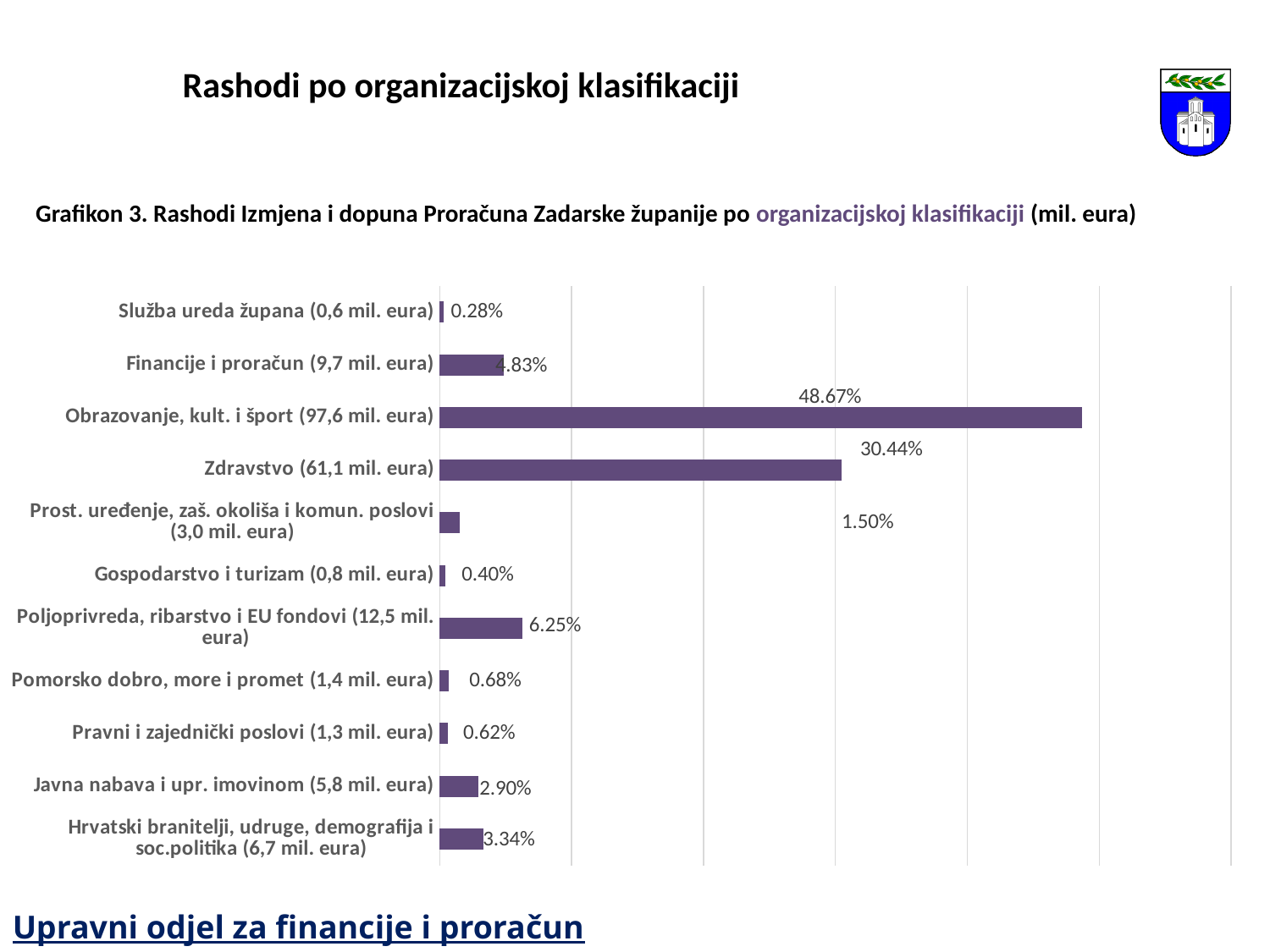
How many categories are shown in the chart? 11 What is the title of the chart (Grafikon 3)? Rashodi Izmjena i dopuna Proračuna Zadarske županije po organizacijskoj klasifikaciji (mil. eura) Which category has the highest percentage? Obrazovanje, kult. i šport (97,6 mil. eura) What percentage is shown for Zdravstvo (61,1 mil. eura)? 30.44% What is the difference in percentage points between Obrazovanje, kult. i šport and Zdravstvo? 18.23% What percentage is shown for Obrazovanje, kult. i šport (97,6 mil. eura)? 48.67% What percentage is shown for Poljoprivreda, ribarstvo i EU fondovi (12,5 mil. eura)? 6.25% What percentage is shown for Javna nabava i upr. imovinom (5,8 mil. eura)? 2.90% Which has a larger percentage: Hrvatski branitelji, udruge, demografija i soc.politika or Javna nabava i upr. imovinom? Hrvatski branitelji, udruge, demografija i soc.politika What kind of chart is shown on the slide? bar chart What is the difference in percentage points between Poljoprivreda, ribarstvo i EU fondovi and Financije i proračun? 1.42% Which category has the lowest percentage? Služba ureda župana (0,6 mil. eura)